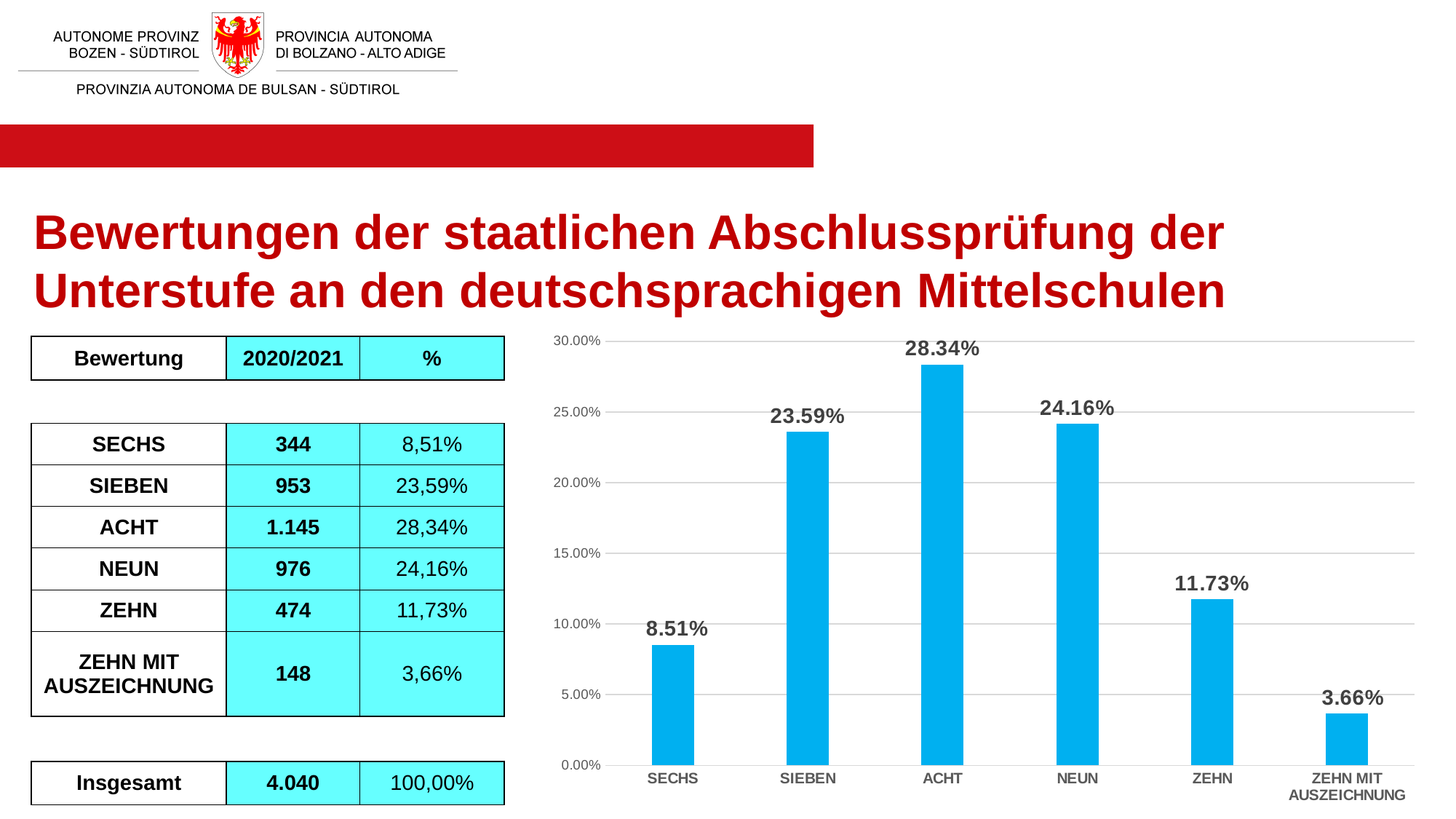
What is the difference between the values for ACHT and SIEBEN in the bar chart? 4.75% What is the difference between the values for ZEHN and ZEHN MIT AUSZEICHNUNG in the bar chart? 8.07% What kind of chart is shown on the slide? bar chart What is the value shown for ZEHN MIT AUSZEICHNUNG in the bar chart? 3.66% What is the value shown for SECHS in the bar chart? 8.51% How many categories are shown on the x axis of the bar chart? 6 Which category has the lowest bar in the chart? ZEHN MIT AUSZEICHNUNG Is the value for ZEHN in the bar chart greater or less than 10.00%? greater Which category has the highest bar in the chart? ACHT Which is larger in the bar chart, the value for NEUN or the value for SIEBEN? NEUN What is the value shown for ACHT in the bar chart? 28.34% What is the highest value labelled on the y axis of the bar chart? 30.00%